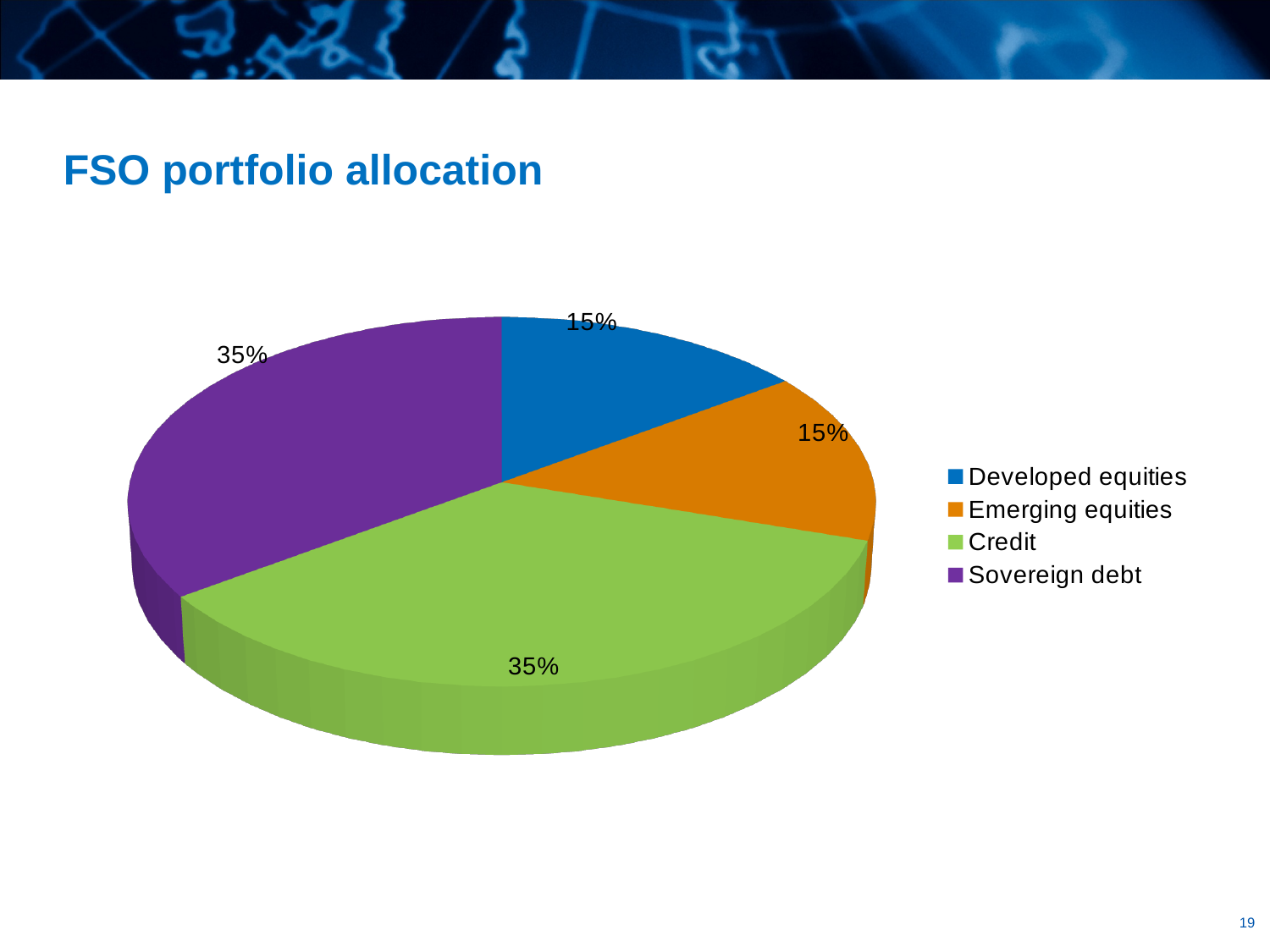
How many categories does the legend list? 4 What share of the portfolio is allocated to Developed equities? 15% What is the title of the chart? FSO portfolio allocation What share of the portfolio is allocated to Sovereign debt? 35% Is the share for Credit greater or less than 25%? greater What kind of chart is shown on the slide? Pie chart What is the difference between the share for Sovereign debt and the share for Developed equities? 20% What is the combined share of Developed equities and Emerging equities? 30% What share of the portfolio is allocated to Credit? 35% Which colour represents Sovereign debt in the chart? Purple Which is larger, the share for Credit or the share for Emerging equities? Credit